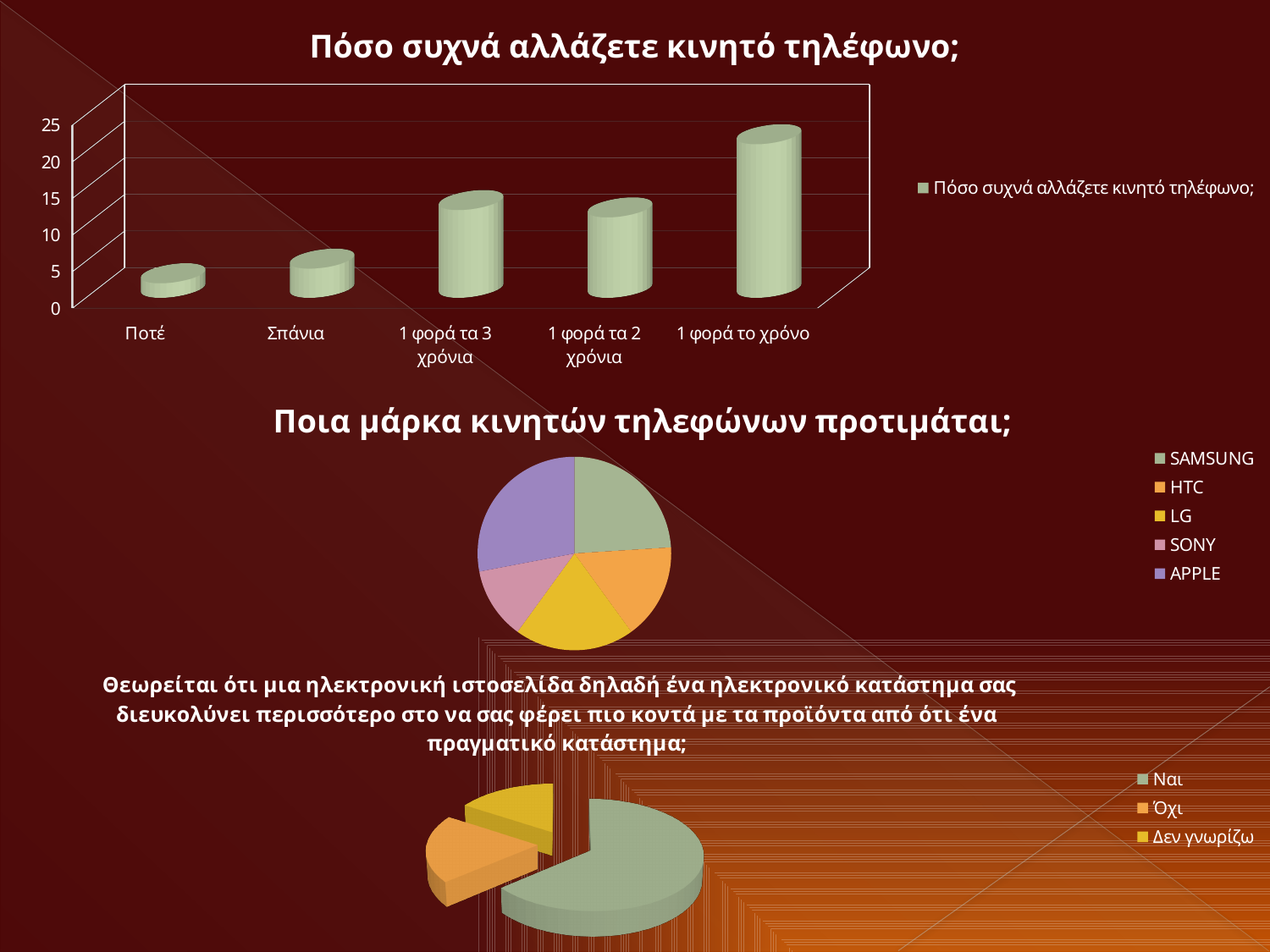
In the chart titled 'Πόσο συχνά αλλάζετε κινητό τηλέφωνο;', which is larger: 'Σπάνια' or '1 φορά τα 3 χρόνια'? 1 φορά τα 3 χρόνια In the pie chart at the bottom of the slide (about the ηλεκτρονική ιστοσελίδα question), which answer has the largest slice? Ναι In the chart titled 'Πόσο συχνά αλλάζετε κινητό τηλέφωνο;', is the value for 'Ποτέ' greater or less than 5? less In the chart titled 'Πόσο συχνά αλλάζετε κινητό τηλέφωνο;', which category has the highest value? 1 φορά το χρόνο In the chart titled 'Πόσο συχνά αλλάζετε κινητό τηλέφωνο;', is the value for '1 φορά το χρόνο' greater or less than 15? greater How many entries does the legend list for the chart titled 'Ποια μάρκα κινητών τηλεφώνων προτιμάται;'? 5 How many categories are shown in the chart titled 'Πόσο συχνά αλλάζετε κινητό τηλέφωνο;'? 5 In the pie chart at the bottom of the slide (about the ηλεκτρονική ιστοσελίδα question), which answer has the smallest slice? Δεν γνωρίζω What kind of chart is the one titled 'Πόσο συχνά αλλάζετε κινητό τηλέφωνο;'? bar chart In the chart titled 'Πόσο συχνά αλλάζετε κινητό τηλέφωνο;', which category has the lowest value? Ποτέ What kind of chart is the one titled 'Ποια μάρκα κινητών τηλεφώνων προτιμάται;'? pie chart In the chart titled 'Ποια μάρκα κινητών τηλεφώνων προτιμάται;', which brand has the smallest slice? SONY